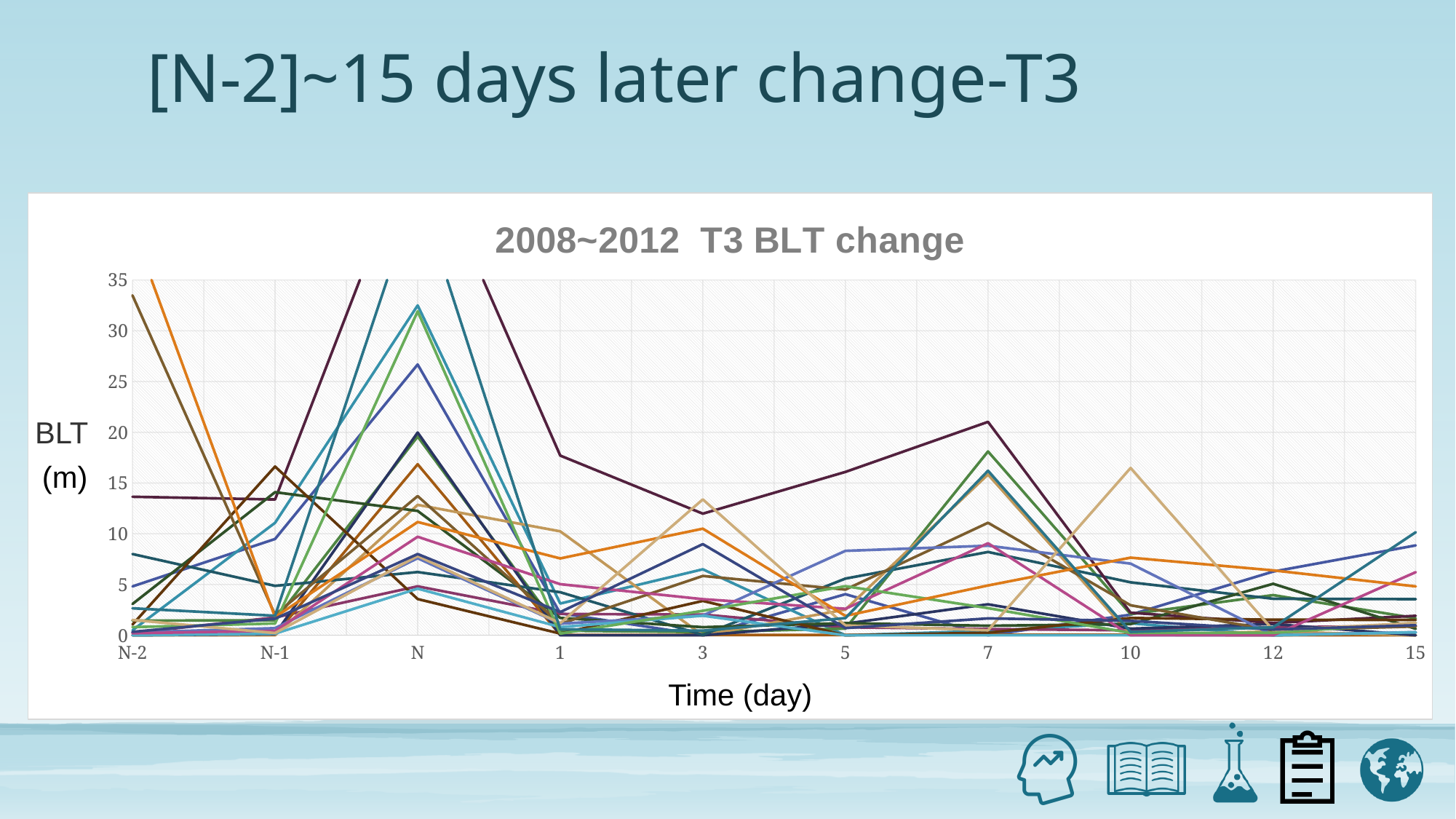
Is the highest line at day 7 greater or less than 20? greater Do any lines rise above the top of the y axis (35) at point N? yes What is the title of the chart? 2008~2012 T3 BLT change How many points are labelled along the x axis of the chart? 10 What kind of chart is shown on the slide? line chart What is the label of the x axis? Time (day) What is the first category label on the x axis? N-2 At which x-axis point do the most lines reach their highest peak? N Is the highest line at day 12 greater or less than 10? less What is the highest tick value shown on the y axis? 35 What is the last category label on the x axis? 15